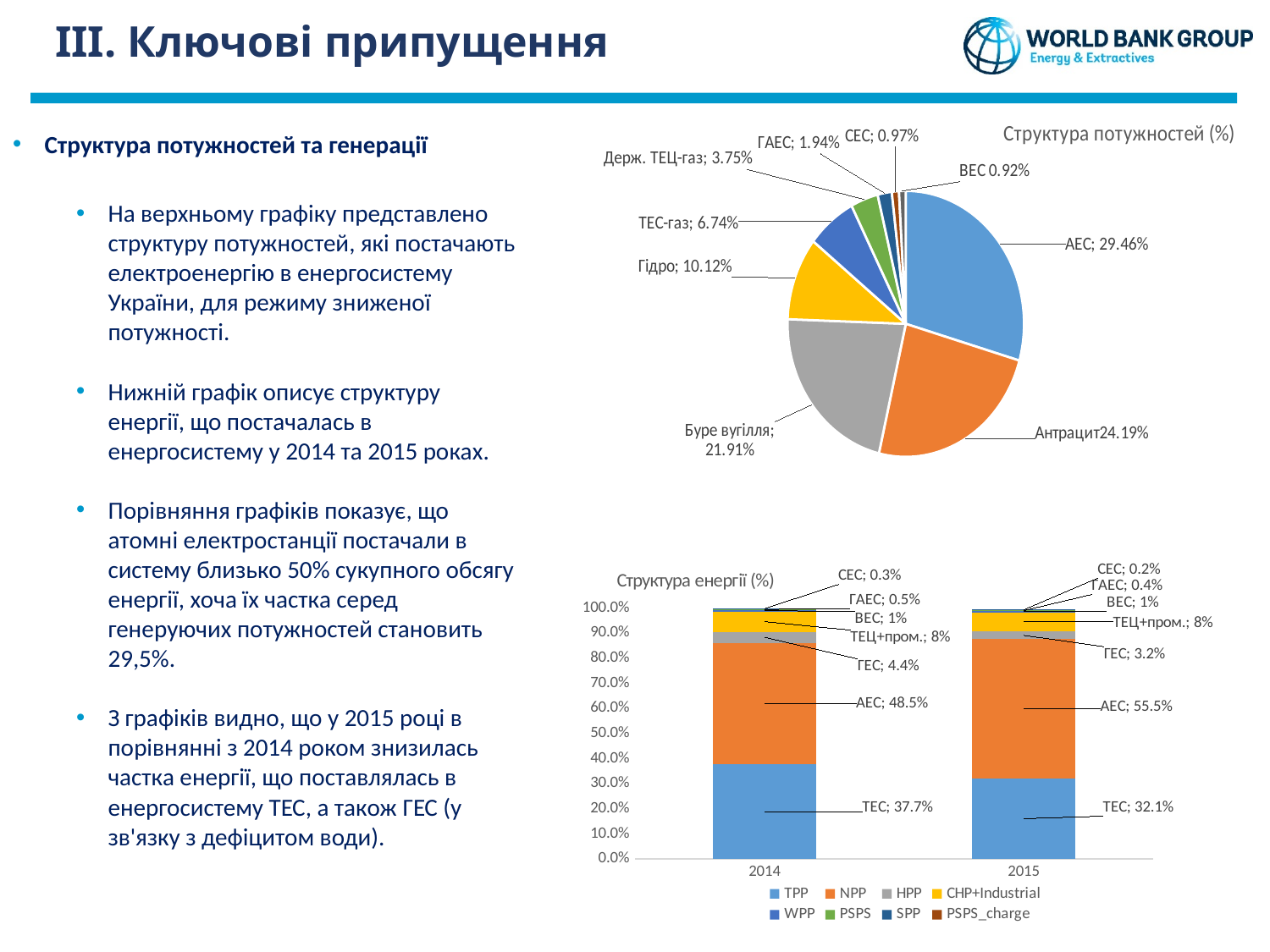
In the bar chart 'Структура енергії (%)', what is the value for ТЕС in 2014? 37.7% In the pie chart 'Структура потужностей (%)', which category has the largest share? АЕС In the bar chart 'Структура енергії (%)', how many series does the legend list? 8 In the pie chart 'Структура потужностей (%)', what is the share for АЕС? 29.46% In the pie chart 'Структура потужностей (%)', what is the difference between the shares of Гідро and ТЕС-газ? 3.38% In the pie chart 'Структура потужностей (%)', how many slices are there? 9 What type of chart is the lower chart 'Структура енергії (%)'? Stacked bar chart In the bar chart 'Структура енергії (%)', what is the value for АЕС in 2015? 55.5% In the bar chart 'Структура енергії (%)', what is the difference between the АЕС values for 2015 and 2014? 7.0% In the pie chart 'Структура потужностей (%)', which category has the smallest share? ВЕС In the bar chart 'Структура енергії (%)', which year has the larger value for ТЕС, 2014 or 2015? 2014 In the pie chart 'Структура потужностей (%)', what is the share for Буре вугілля? 21.91%